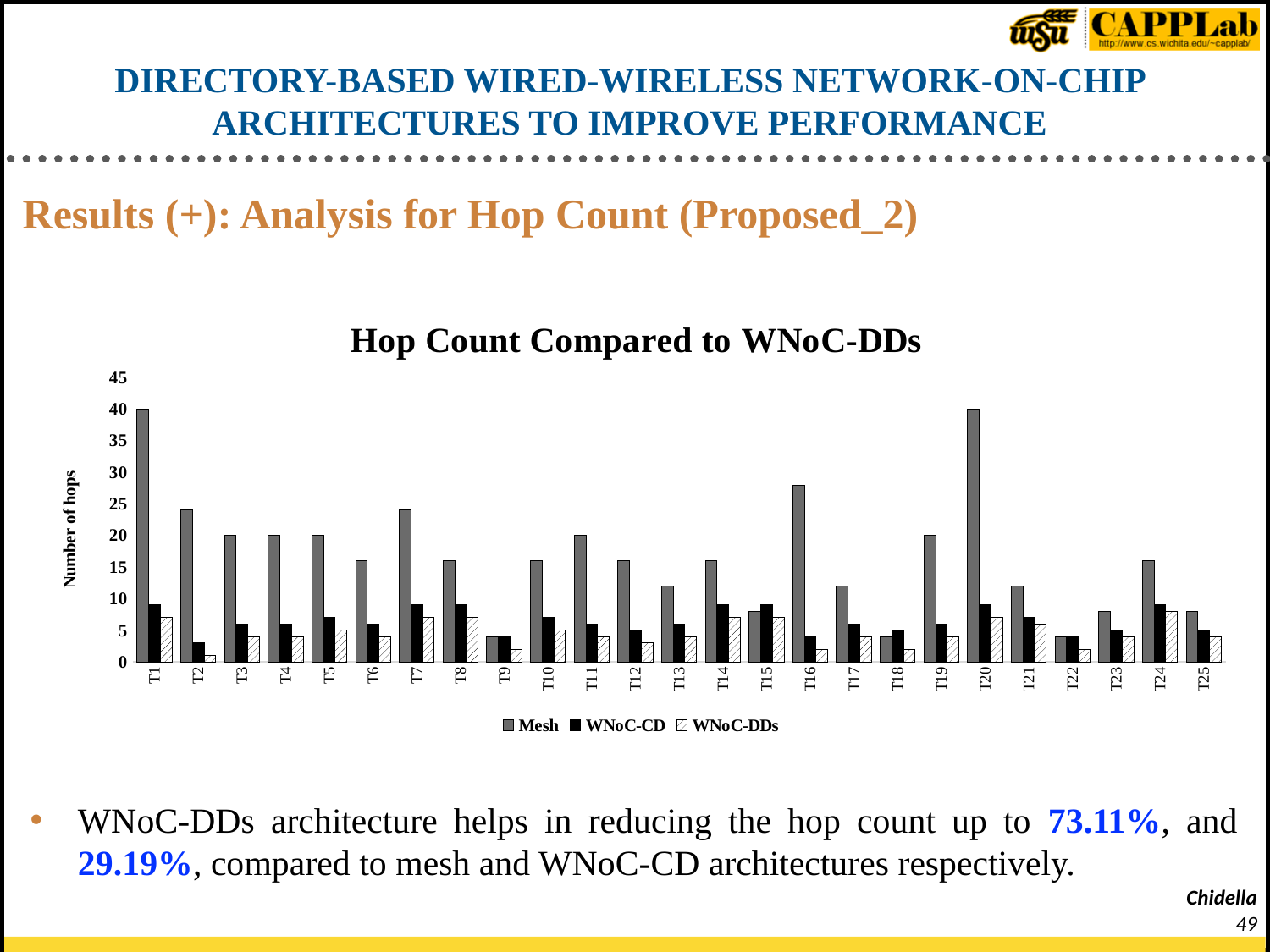
Is the WNoC-CD value for T1 greater or less than 5? greater Which is larger, the Mesh value for T1 or the Mesh value for T2? T1 Is the Mesh value for T16 greater or less than 25? greater How many series does the chart legend list? 3 What is the title of the chart? Hop Count Compared to WNoC-DDs Is the WNoC-DDs value for T2 greater or less than 5? less Which is larger for T1, the WNoC-CD value or the WNoC-DDs value? WNoC-CD How many categories (T1 to T25) are shown on the x axis? 25 What is the Mesh value for T1? 40 What is the label of the y axis? Number of hops What type of chart is shown on the slide? bar chart